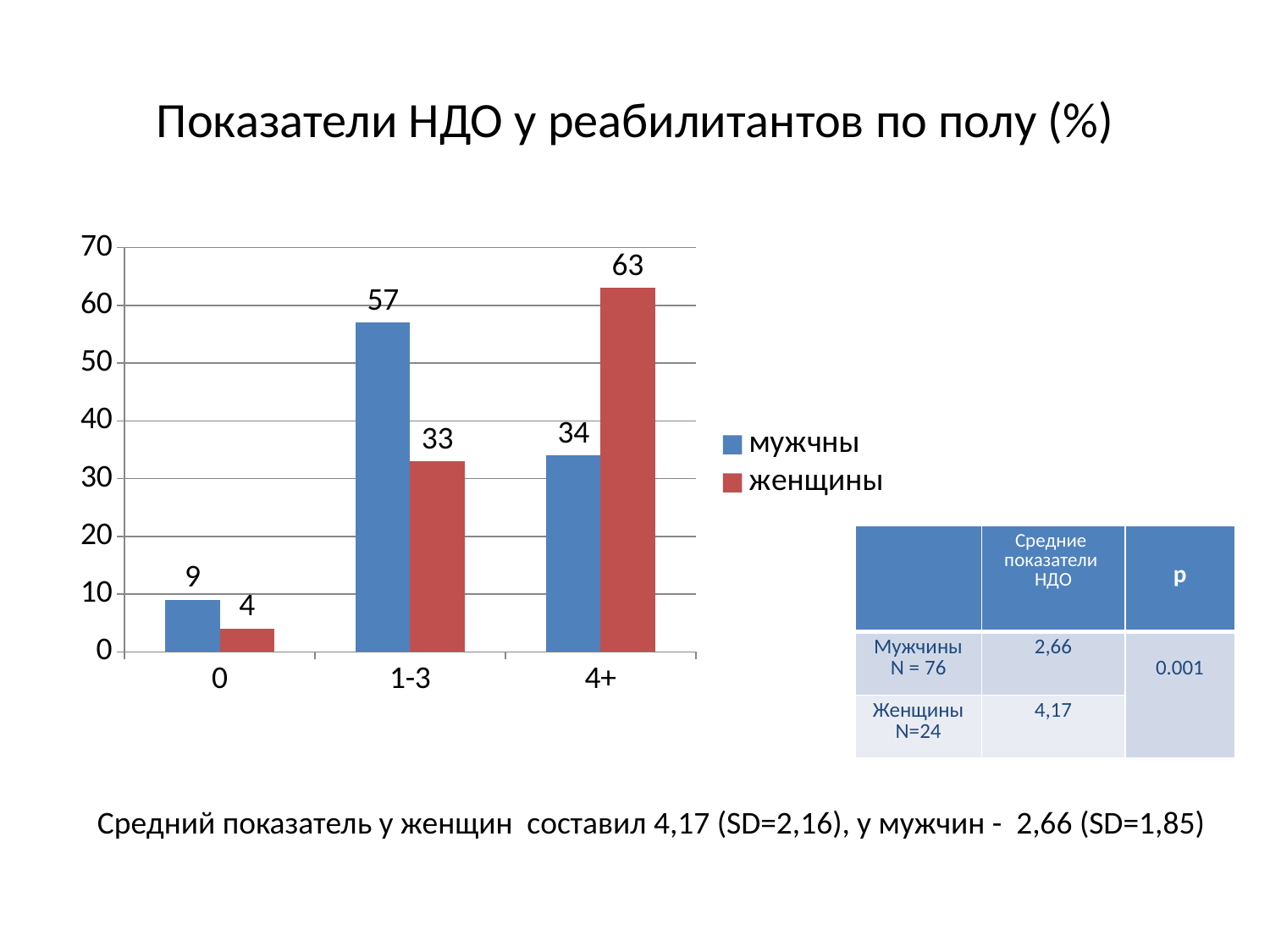
What is the difference between женщины and мужчны in the 4+ category? 29 What colour are the bars for женщины? red Which category has the lowest value for мужчны? 0 Is the value for мужчны in the 4+ category greater or less than 40? less How many categories are shown on the x axis? 3 In the 1-3 category, which series has the larger value, мужчны or женщины? мужчны What is the value for мужчны in the 1-3 category? 57 Which category has the highest value for женщины? 4+ What is the value for женщины in the 4+ category? 63 What is the value for женщины in the 0 category? 4 How many series does the legend list? 2 What kind of chart is shown on the slide? bar chart